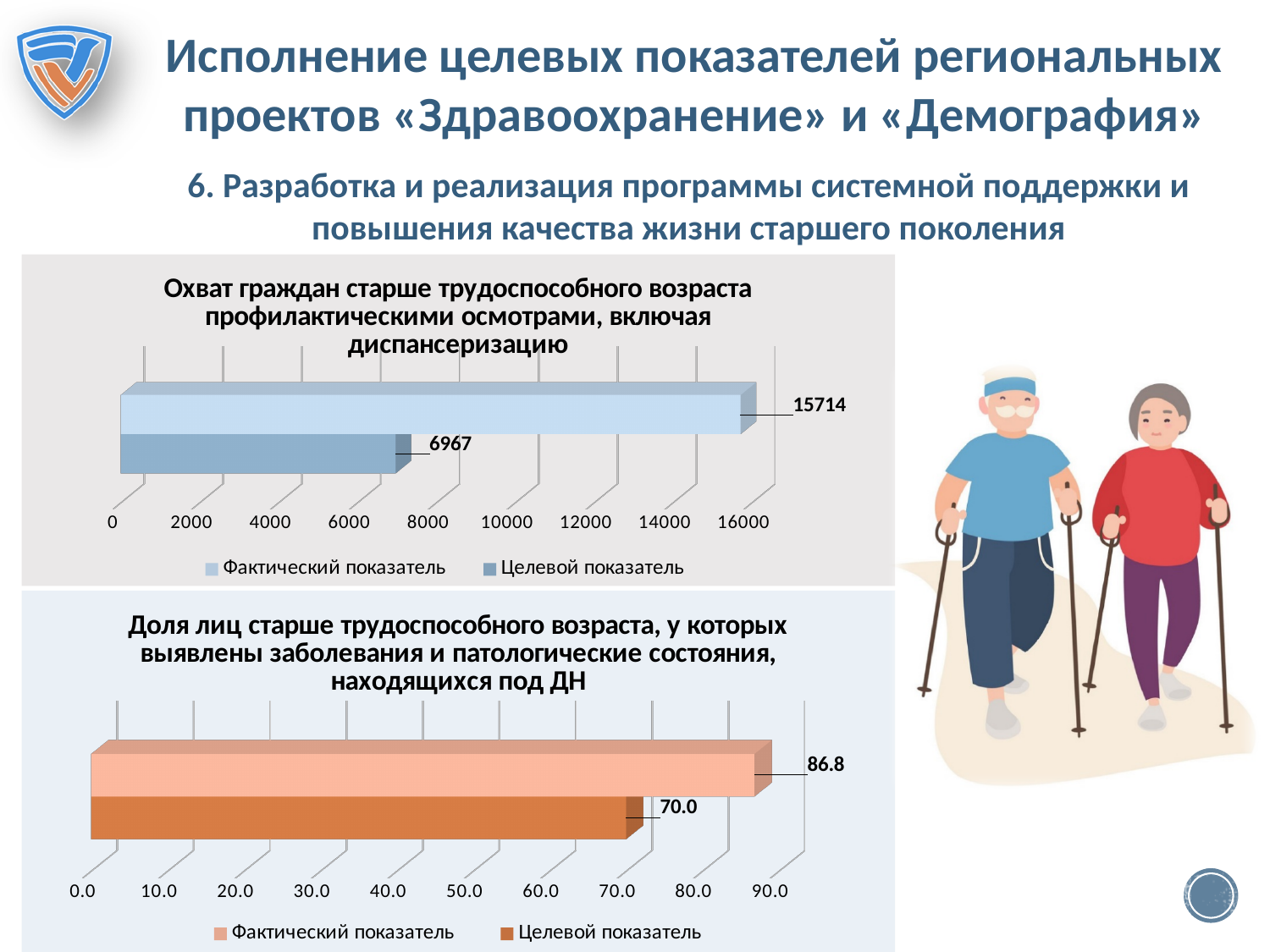
What kind of chart is the top chart (Охват граждан старше трудоспособного возраста профилактическими осмотрами)? Bar chart In the top chart (Охват граждан старше трудоспособного возраста профилактическими осмотрами), which is larger: Фактический показатель or Целевой показатель? Фактический показатель In the top chart (Охват граждан старше трудоспособного возраста профилактическими осмотрами), what is the difference between Фактический показатель and Целевой показатель? 8747 In the bottom chart (Доля лиц старше трудоспособного возраста, находящихся под ДН), is the value for Фактический показатель greater or less than 80.0? greater In the bottom chart (Доля лиц старше трудоспособного возраста, находящихся под ДН), what is the value of Фактический показатель? 86.8 In the bottom chart (Доля лиц старше трудоспособного возраста, находящихся под ДН), what is the value of Целевой показатель? 70.0 In the bottom chart (Доля лиц старше трудоспособного возраста, находящихся под ДН), which series has the lowest value? Целевой показатель In the bottom chart (Доля лиц старше трудоспособного возраста, находящихся под ДН), what colour is the bar for Целевой показатель? Orange In the bottom chart (Доля лиц старше трудоспособного возраста, находящихся под ДН), what is the difference between Фактический показатель and Целевой показатель? 16.8 In the top chart (Охват граждан старше трудоспособного возраста профилактическими осмотрами), how many series does the legend list? 2 In the top chart (Охват граждан старше трудоспособного возраста профилактическими осмотрами), what is the value of Целевой показатель? 6967 In the top chart (Охват граждан старше трудоспособного возраста профилактическими осмотрами), what is the value of Фактический показатель? 15714